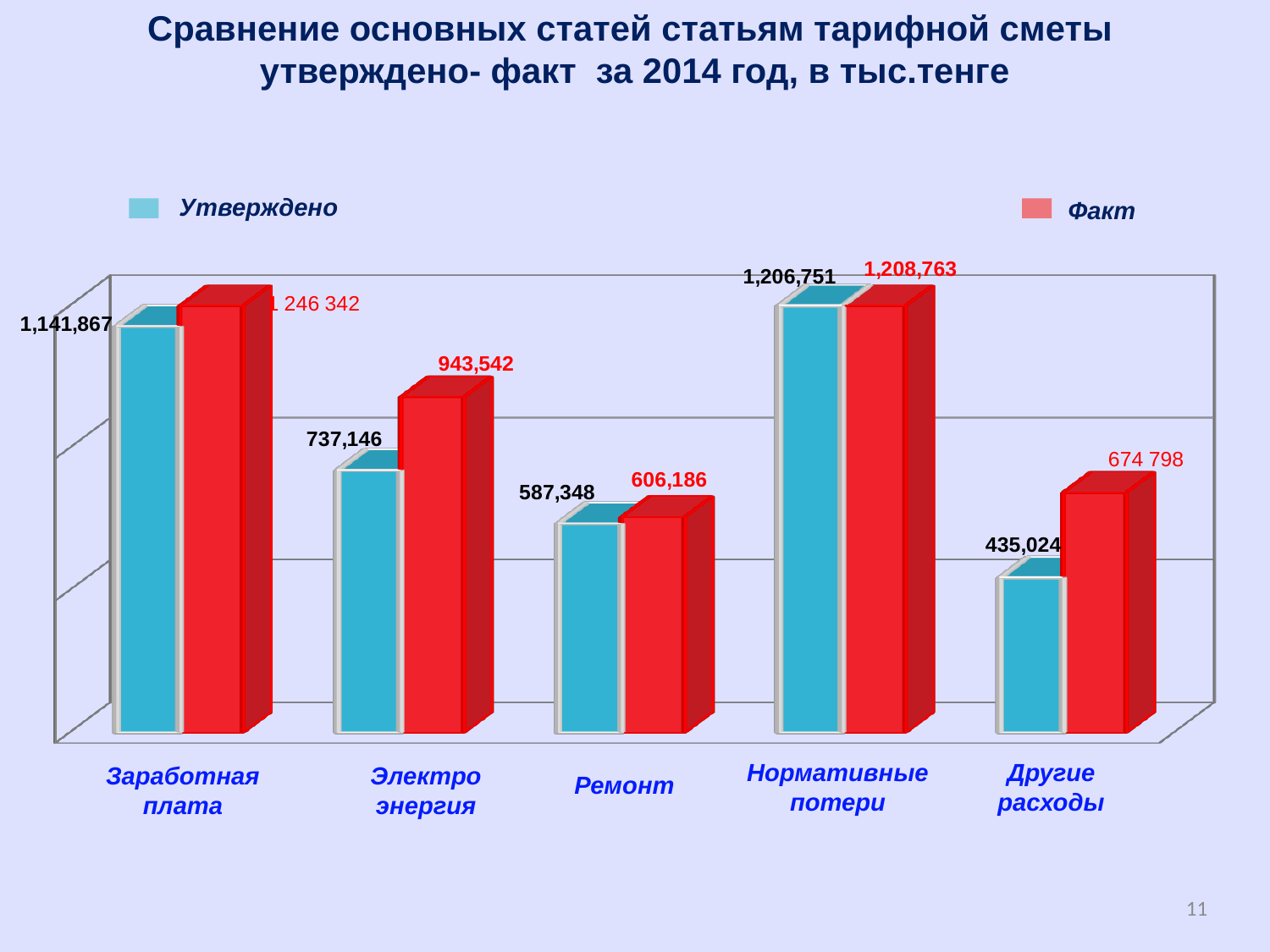
Which category has the lowest Утверждено value? Другие расходы For Другие расходы, which is larger: the Утверждено value or the Факт value? Факт What type of chart is shown on the slide? bar chart What is the Утверждено value for Нормативные потери? 1,206,751 How many series does the legend list? 2 What is the Факт value for Другие расходы? 674 798 Which category has the lowest Факт value? Ремонт What is the Утверждено value for Электро энергия? 737,146 How many categories are shown on the x axis? 5 What is the Факт value for Ремонт? 606,186 What is the difference between the Факт and Утверждено values for Электро энергия? 206,396 Which category has the highest Утверждено value? Нормативные потери